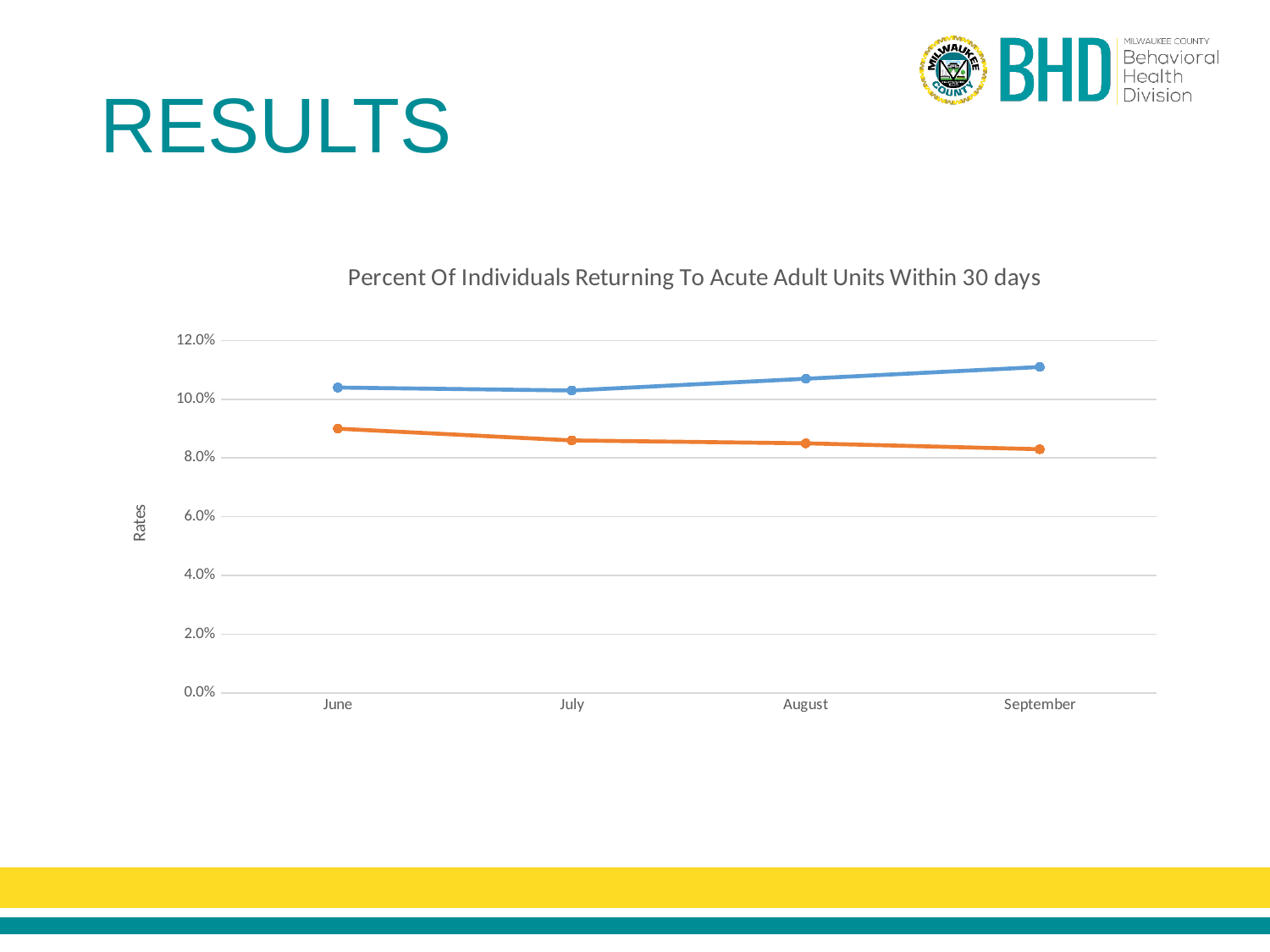
In which month does the blue line reach its highest value? September What is the label of the vertical axis? Rates How many months are plotted along the x axis of the chart? 4 Is the value of the blue line for June greater or less than 10.0%? greater Is the value of the orange line for July greater or less than 8.0%? greater Is the value of the blue line for September greater or less than 12.0%? less What kind of chart is shown on the slide? line chart Which line has the higher value in August, the blue line or the orange line? the blue line How many lines are plotted on the chart? 2 In which month does the orange line have its highest value? June What is the title of the chart? Percent Of Individuals Returning To Acute Adult Units Within 30 days